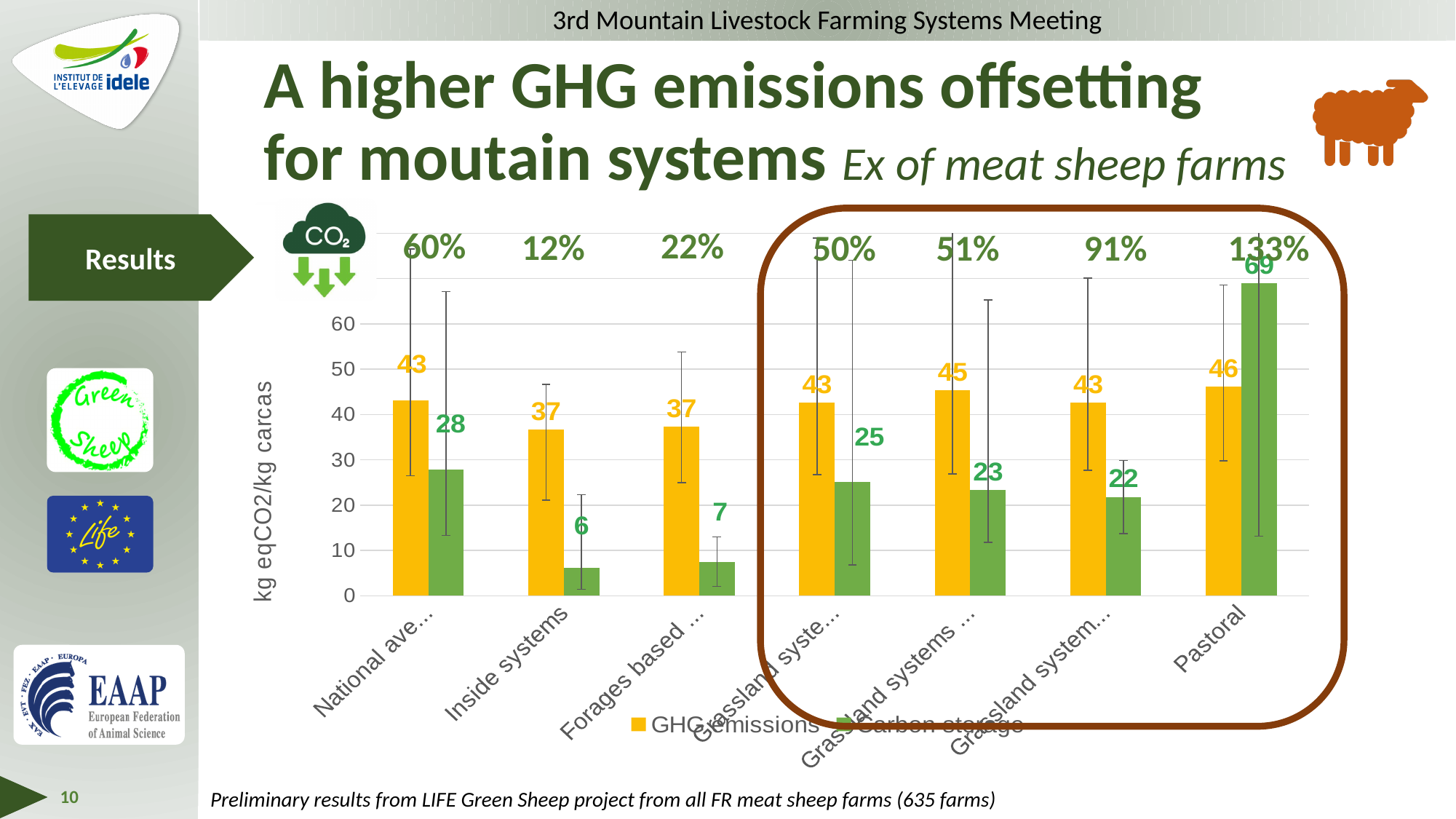
Which has the larger GHG emissions value: Inside systems or Pastoral? Pastoral What percentage is printed above the Pastoral bars? 133% For Pastoral, what is the difference between the Carbon storage value and the GHG emissions value? 23 For Pastoral, which is larger: GHG emissions or Carbon storage? Carbon storage How many categories are shown on the x axis? 7 What is the Carbon storage value for Inside systems? 6 Which category has the highest Carbon storage value? Pastoral What kind of chart is shown on the slide? Bar chart What is the Carbon storage value for Pastoral? 69 What is the GHG emissions value for Inside systems? 37 Which category has the lowest Carbon storage value? Inside systems How many series does the legend list? 2